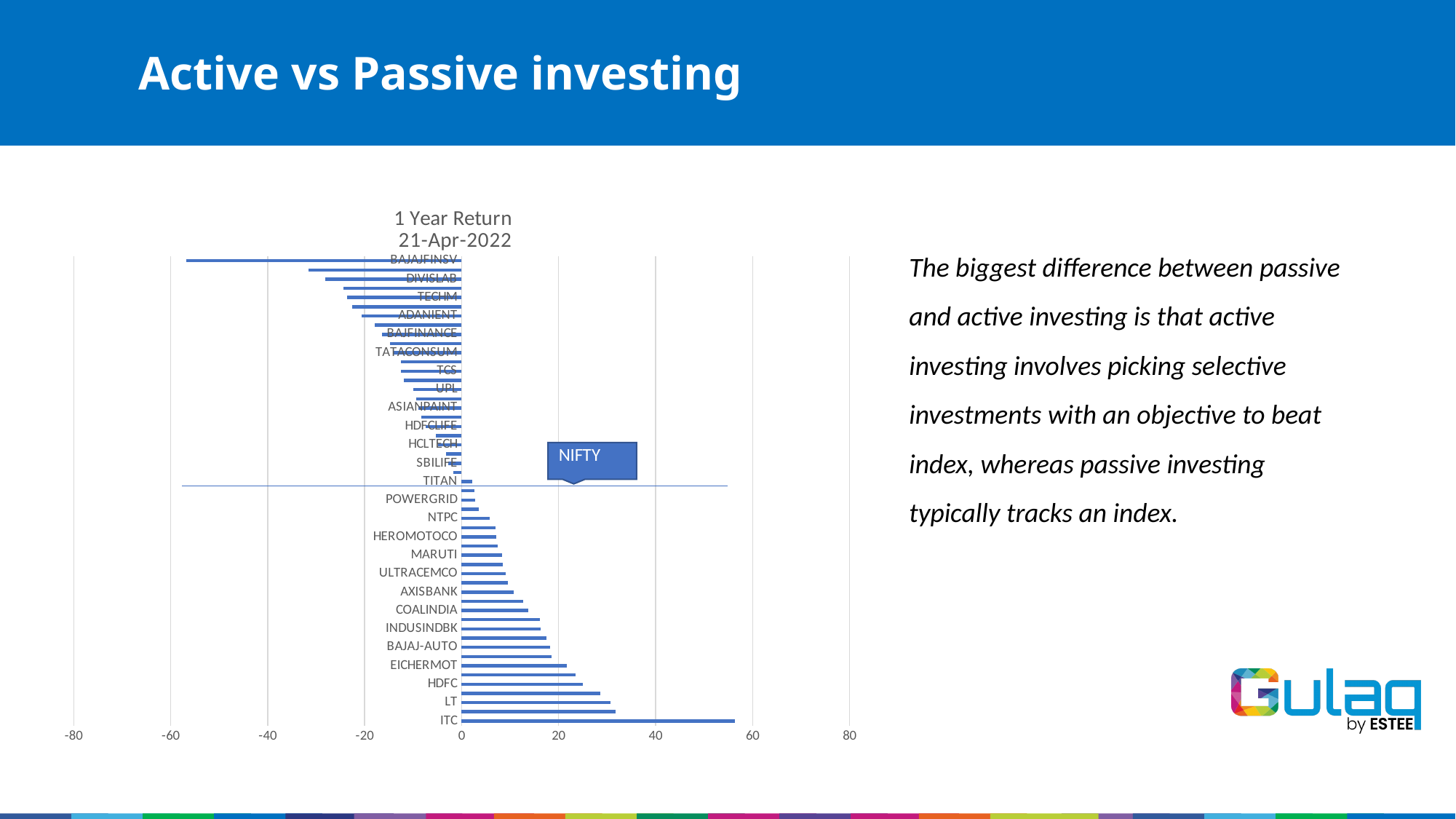
What is the title of the chart? 1 Year Return 21-Apr-2022 What label is shown in the callout box placed near the middle of the chart? NIFTY Which stock has the highest 1 year return in the chart? ITC Is the value for DIVISLAB greater or less than -20? less Which has the larger 1 year return, HDFC or NTPC? HDFC What kind of chart is shown on the slide? bar chart Is the value for BAJAJFINSV greater or less than -40? less Is the value for LT greater or less than 20? greater Which has the larger 1 year return, ITC or LT? ITC Which stock has the lowest 1 year return in the chart? BAJAJFINSV